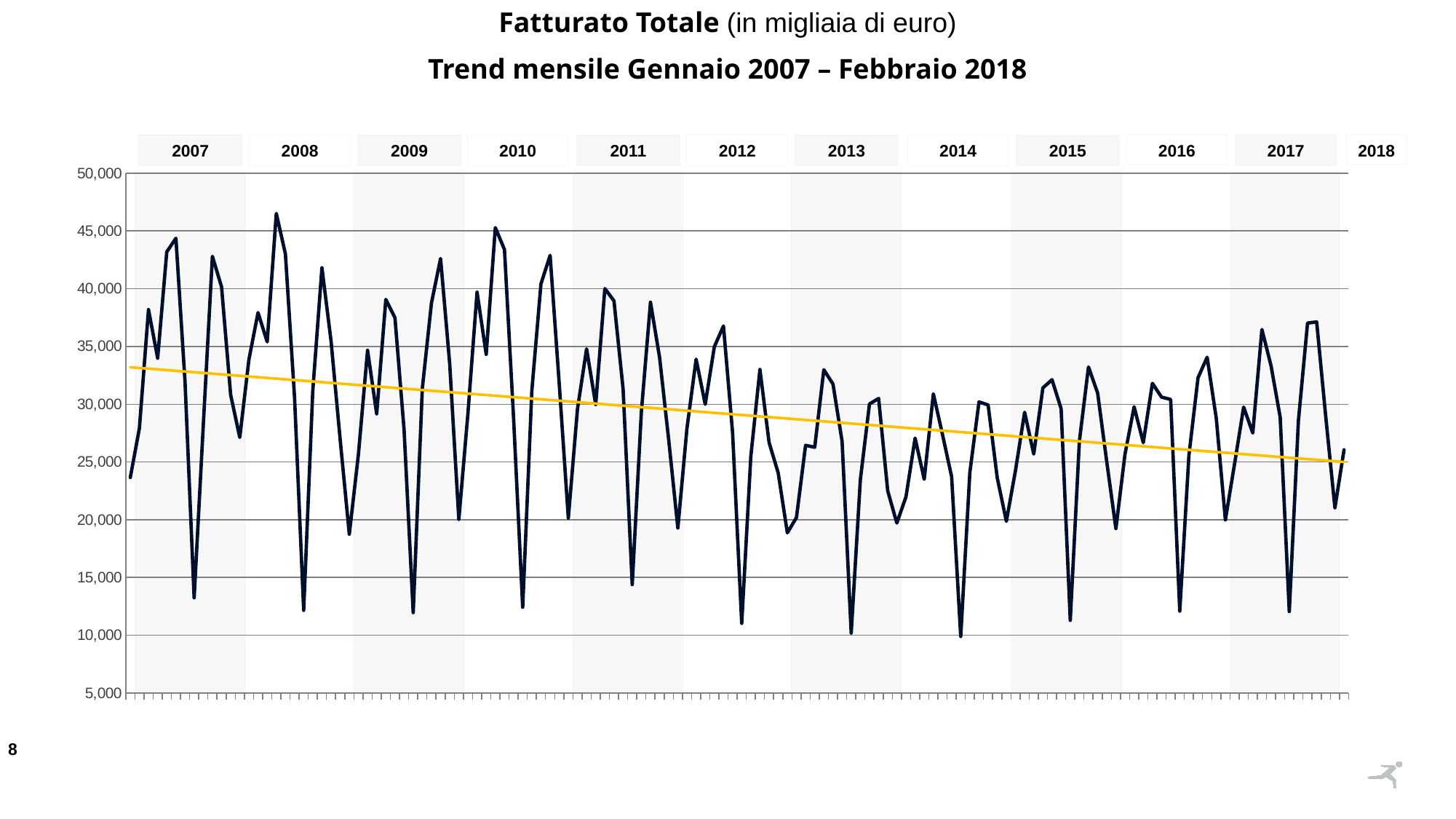
Is the highest peak in 2017 greater or less than 40,000? less Does the orange trend line rise or fall from 2007 to 2018? fall What is the highest value shown on the vertical axis? 50,000 Is the value of the trend line at the start of 2007 greater or less than 30,000? greater Is the lowest point in 2007 greater or less than 15,000? less In what unit is the Fatturato Totale expressed according to the title? in migliaia di euro Which year contains the highest peak of the monthly line? 2008 Which is higher: the highest peak in 2008 or the highest peak in 2017? 2008 What kind of chart is shown on the slide? line chart How many year labels are shown along the top of the chart? 12